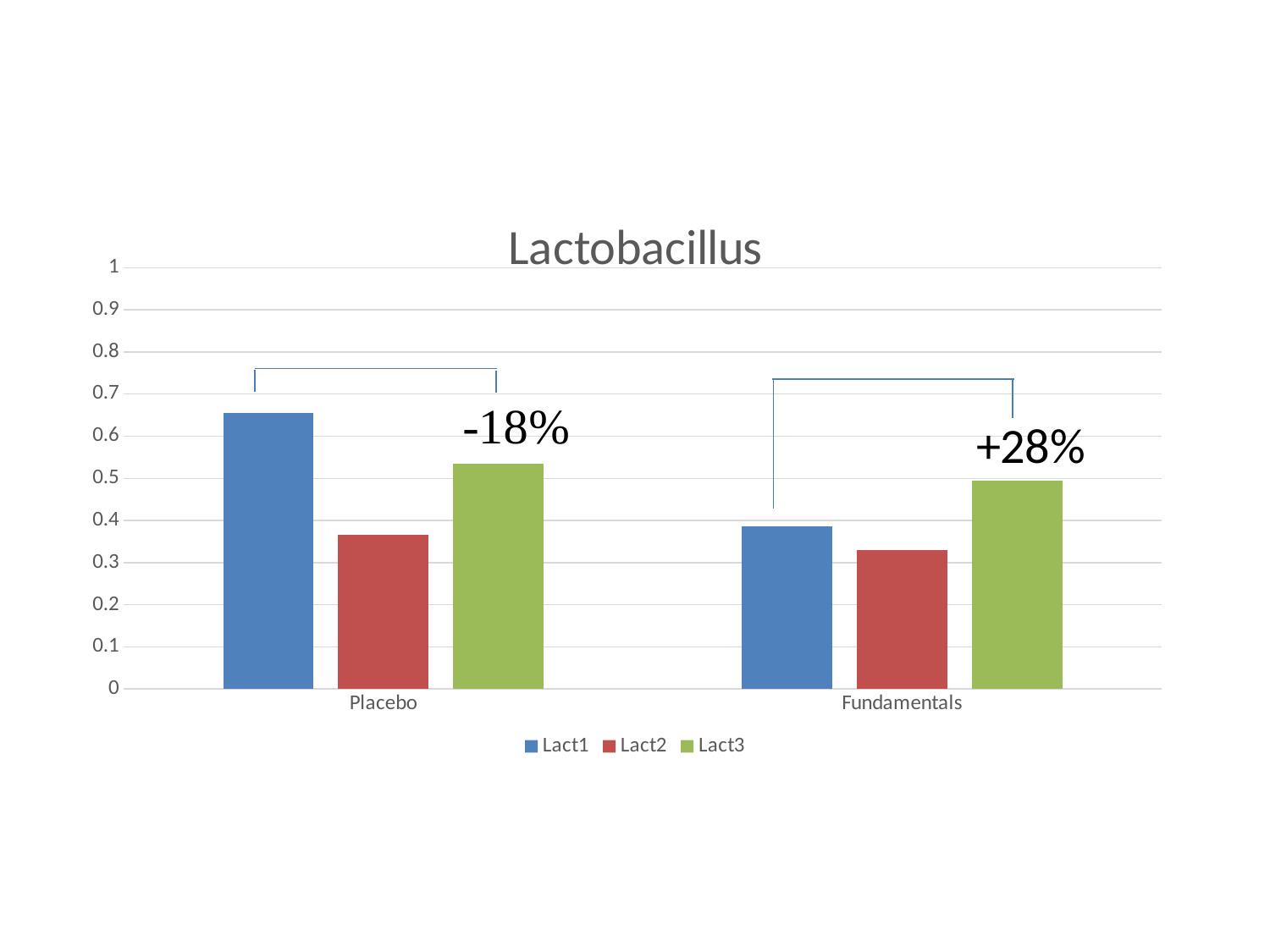
Which series has the highest value in the Fundamentals category? Lact3 Is the value for Lact1 in the Placebo category greater or less than 0.6? greater Which series has the lowest value in the Placebo category? Lact2 How many series does the legend list? 3 Which series has the highest value in the Placebo category? Lact1 How many categories are shown on the x axis? 2 What kind of chart is shown on the slide? bar chart Which is larger: Lact1 in the Placebo category or Lact1 in the Fundamentals category? Lact1 in the Placebo category Is the value for Lact2 in the Fundamentals category greater or less than 0.4? less Which series has the lowest value in the Fundamentals category? Lact2 What is the title of the chart? Lactobacillus What percentage change is annotated above the Fundamentals bars? +28%